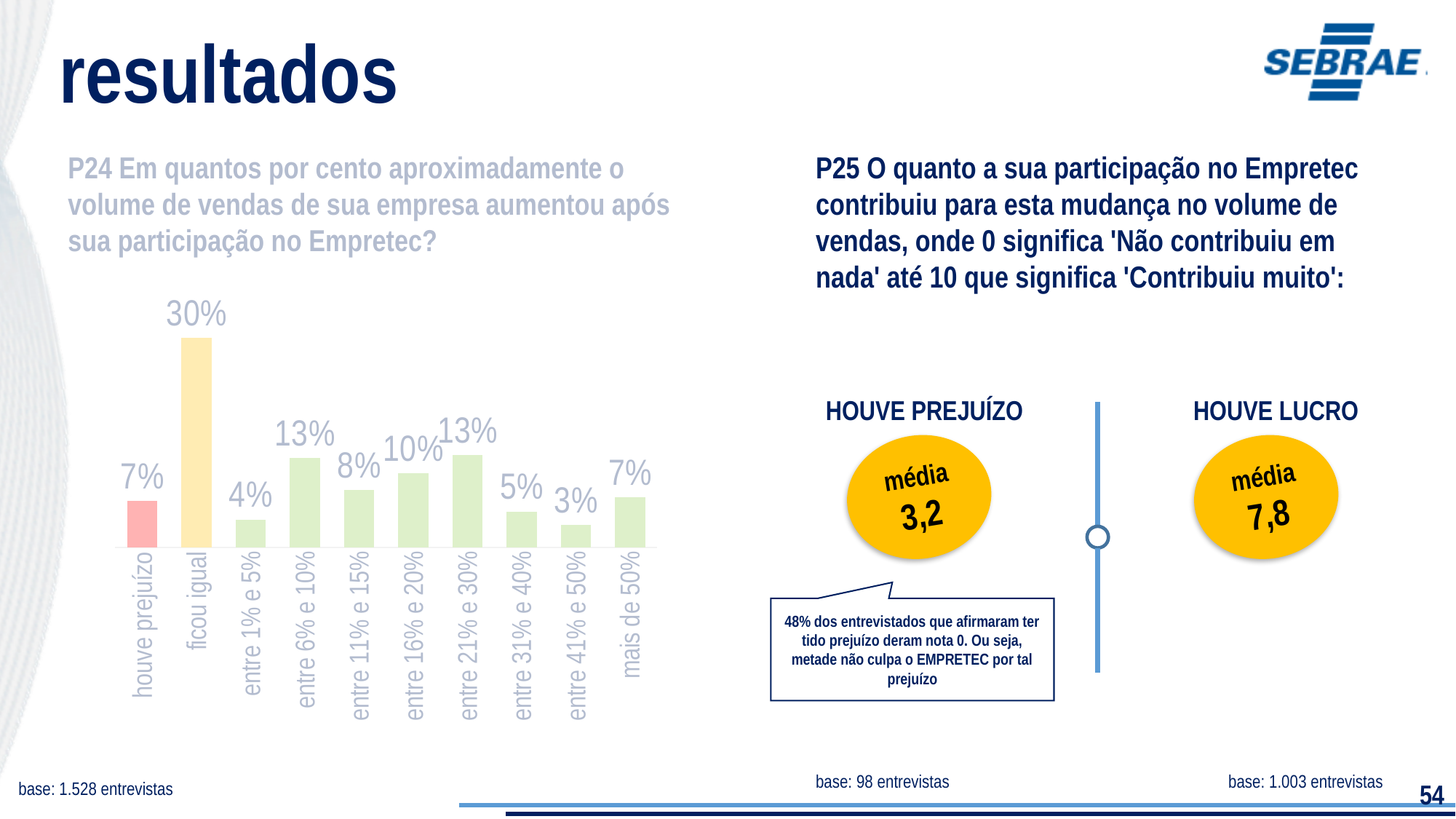
In the P24 bar chart, which is larger: the value for 'entre 6% e 10%' or for 'entre 11% e 15%'? entre 6% e 10% In the P24 bar chart, which is larger: the value for 'entre 31% e 40%' or for 'mais de 50%'? mais de 50% In the P24 bar chart, which category has the lowest value? entre 41% e 50% How many categories are shown in the P24 bar chart? 10 In the P24 bar chart, what percentage is shown for 'entre 41% e 50%'? 3% In the P24 bar chart, which category has the highest value? ficou igual In the P24 bar chart, what percentage is shown for 'ficou igual'? 30% In the P24 bar chart, what percentage is shown for 'houve prejuízo'? 7% In the P24 bar chart, what colour is the bar for 'ficou igual'? Yellow In the P24 bar chart, what percentage is shown for 'entre 16% e 20%'? 10% What type of chart is used for question P24 on the slide? Bar chart In the P24 bar chart, what is the difference in percentage points between 'ficou igual' and 'houve prejuízo'? 23 percentage points